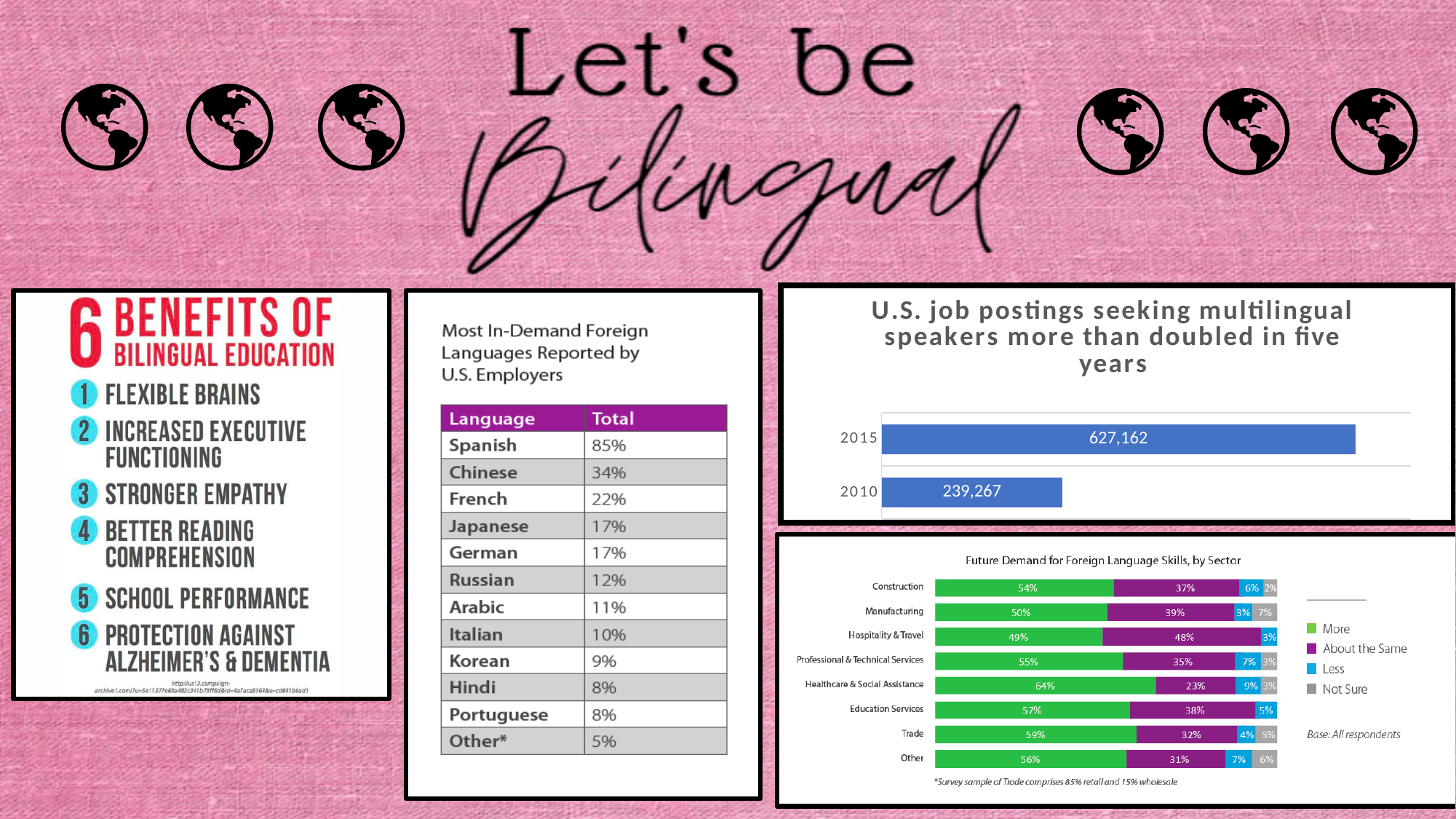
In the chart 'Future Demand for Foreign Language Skills, by Sector', how many sectors are shown? 8 In the chart titled 'U.S. job postings seeking multilingual speakers more than doubled in five years', what is the difference between the 2015 and 2010 values? 387,895 How many years are shown in the 'U.S. job postings seeking multilingual speakers' chart? 2 In the chart 'Future Demand for Foreign Language Skills, by Sector', which sector has the lowest 'More' percentage? Hospitality & Travel In the chart 'Future Demand for Foreign Language Skills, by Sector', which sector has the highest 'More' percentage? Healthcare & Social Assistance In the chart titled 'U.S. job postings seeking multilingual speakers more than doubled in five years', what is the value for 2015? 627,162 In the chart 'Future Demand for Foreign Language Skills, by Sector', how many series does the legend list? 4 In the chart 'Future Demand for Foreign Language Skills, by Sector', which is larger for Trade: the 'More' share or the 'About the Same' share? More In the chart 'Future Demand for Foreign Language Skills, by Sector', what percentage of Manufacturing respondents answered 'About the Same'? 39% In the chart 'Future Demand for Foreign Language Skills, by Sector', what percentage of Healthcare & Social Assistance respondents answered 'More'? 64% In the chart titled 'U.S. job postings seeking multilingual speakers more than doubled in five years', what is the value for 2010? 239,267 What kind of chart is the 'U.S. job postings seeking multilingual speakers' chart? bar chart